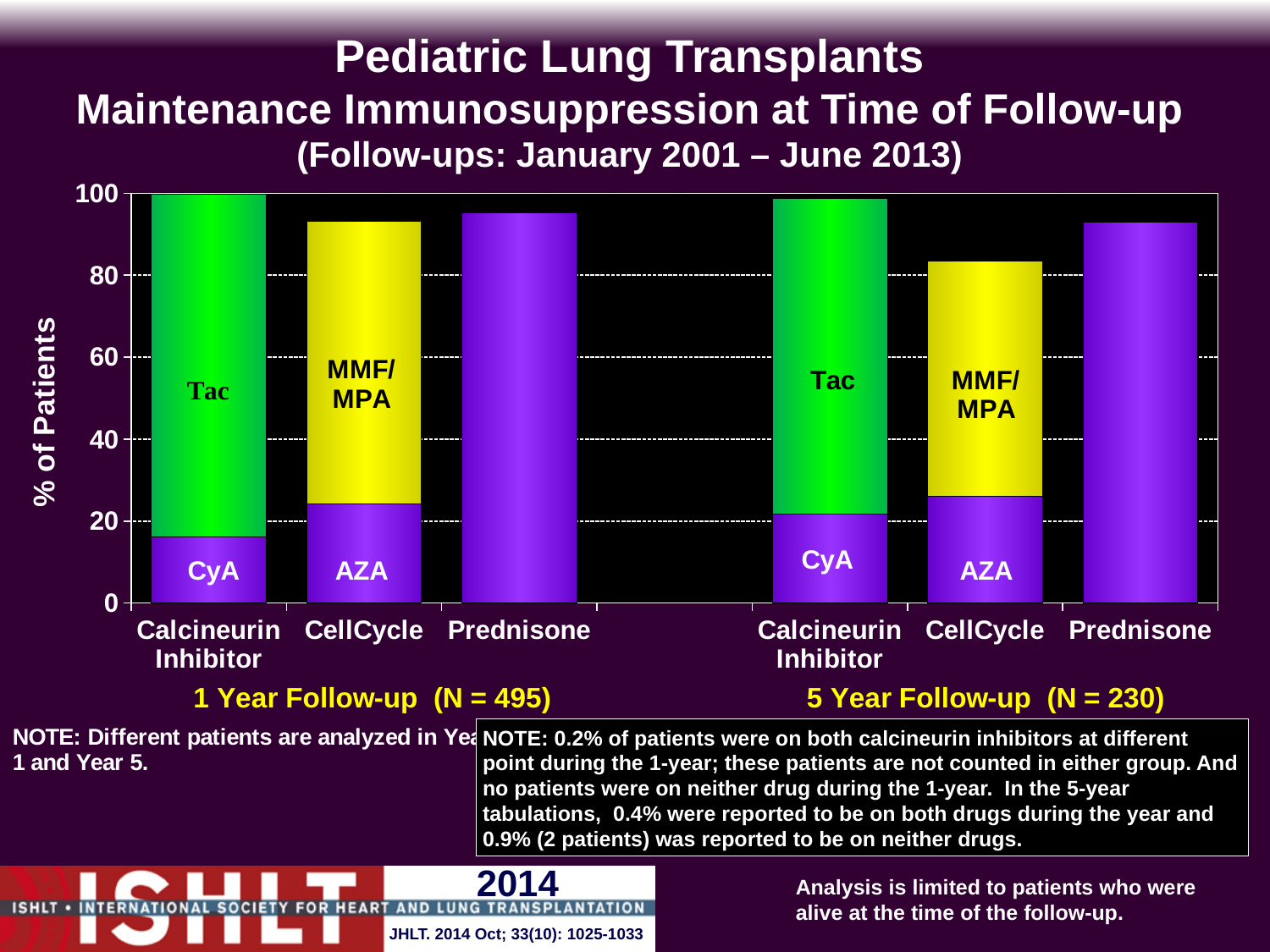
Which is taller, the CellCycle bar in the 1 Year Follow-up chart or the CellCycle bar in the 5 Year Follow-up chart? 1 Year Follow-up How many categories are shown on the x axis of the 1 Year Follow-up chart? 3 In the 5 Year Follow-up chart, is the AZA portion of the CellCycle bar greater or less than 40? less In the 1 Year Follow-up chart, which is larger within the Calcineurin Inhibitor bar, the Tac portion or the CyA portion? Tac In the 1 Year Follow-up chart, which category has the highest total bar height? Calcineurin Inhibitor In the 5 Year Follow-up chart, which category has the lowest total bar height? CellCycle In the 1 Year Follow-up chart, is the CyA portion of the Calcineurin Inhibitor bar greater or less than 20? less In the 1 Year Follow-up chart, is the value for Prednisone greater or less than 80? greater What kind of chart is shown on the slide? Stacked bar chart What is the N for the 5 Year Follow-up chart? N = 230 What is the label on the y axis? % of Patients